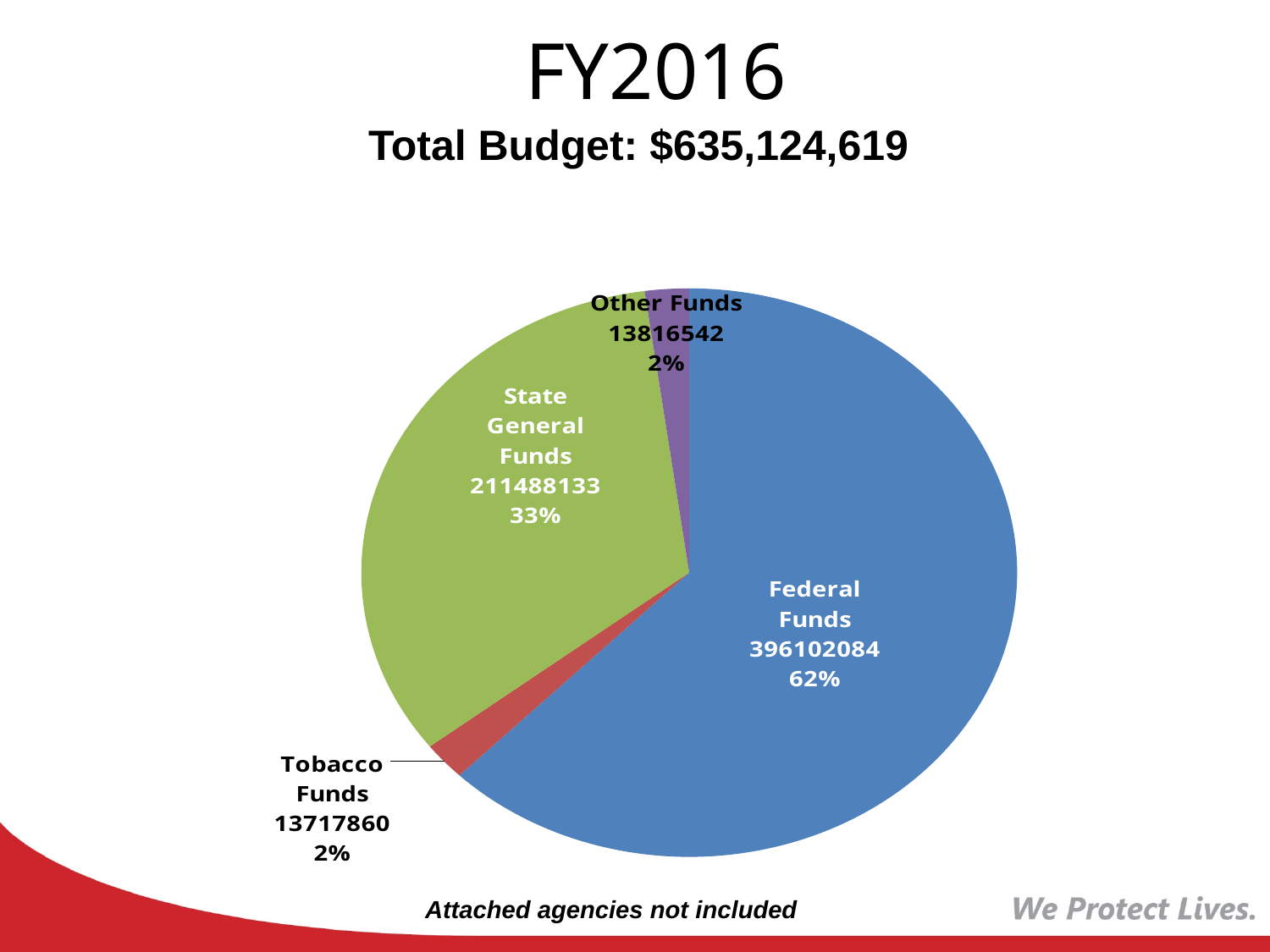
What share of the pie do State General Funds represent? 33% What is the value shown for State General Funds? 211488133 What kind of chart is shown on the slide? pie chart Which category has the largest slice of the pie? Federal Funds What share of the pie do Federal Funds represent? 62% What is the value shown for Tobacco Funds? 13717860 What total budget is stated in the slide's subtitle? $635,124,619 What is the difference between the Federal Funds value and the State General Funds value? 184613951 How many slices does the pie chart have? 4 What is the value shown for Federal Funds? 396102084 What is the value shown for Other Funds? 13816542 Which is larger, State General Funds or Other Funds? State General Funds